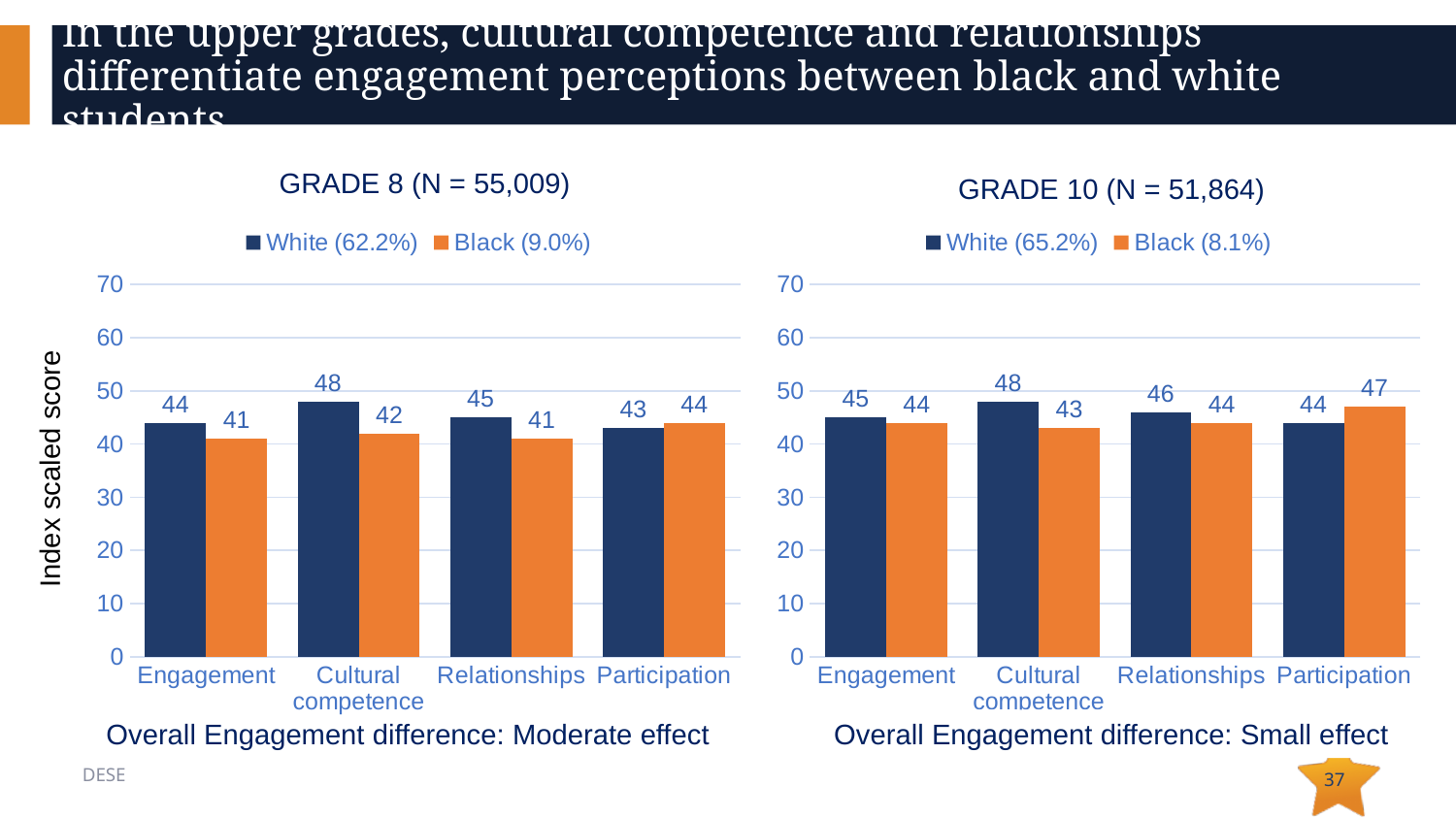
In the GRADE 8 chart, which is larger for Participation: the White value or the Black value? Black In the GRADE 8 chart, which category has the highest value for White students? Cultural competence How many series does the legend of the GRADE 8 chart list? 2 In the GRADE 10 chart, what is the difference between the Black and White values for Participation? 3 In the GRADE 8 chart, what is the difference between the White and Black values for Cultural competence? 6 In the GRADE 8 chart, what is the value for Black students on Engagement? 41 How many categories are shown on the x axis of the GRADE 10 chart? 4 In the GRADE 10 chart, what is the value for Black students on Participation? 47 In the GRADE 8 chart, what is the value for White students on Cultural competence? 48 In the GRADE 10 chart, which category has the lowest value for Black students? Cultural competence What kind of chart is the GRADE 10 chart? Bar chart In the GRADE 10 chart, what is the value for White students on Relationships? 46